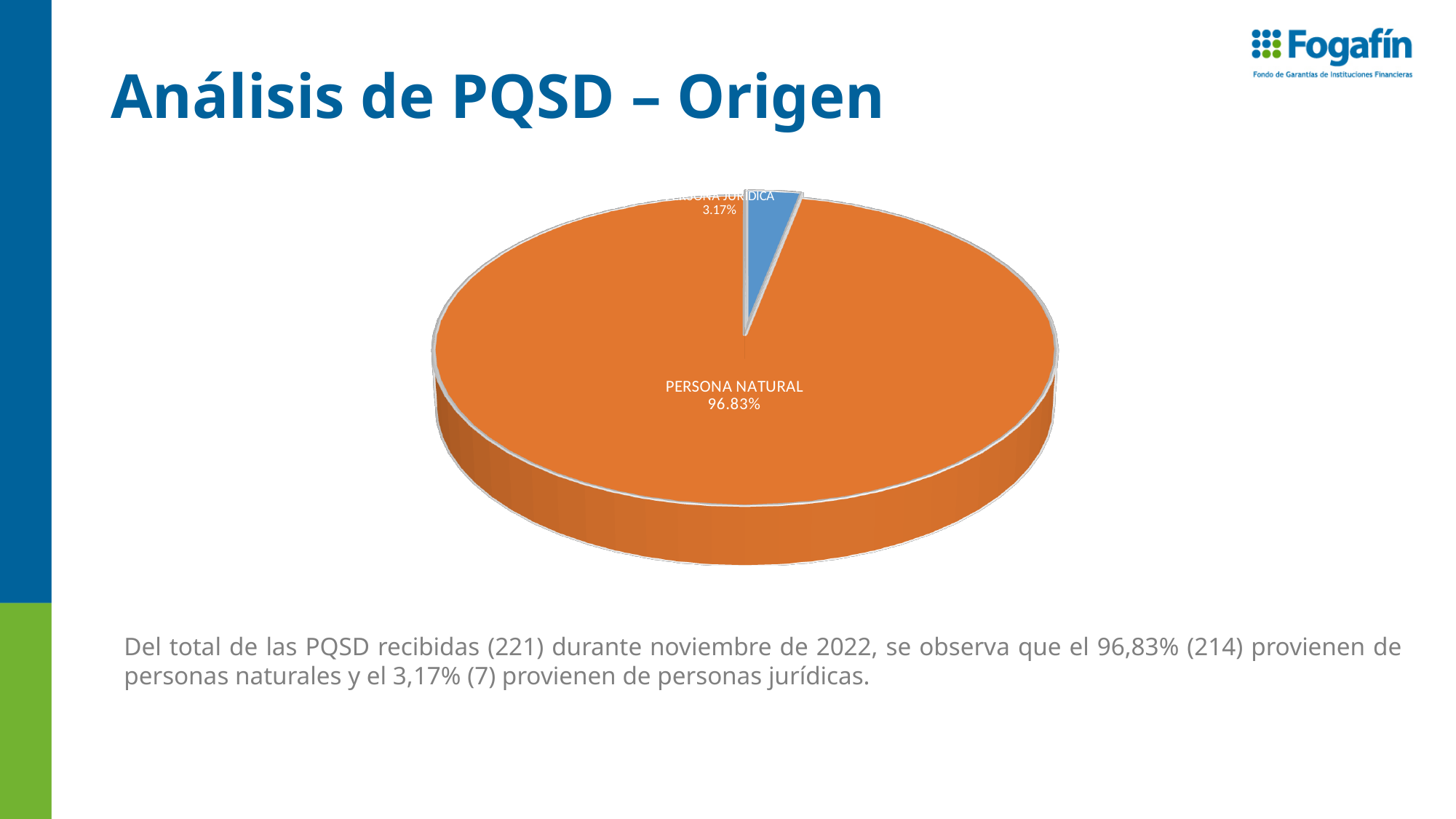
What kind of chart is shown on the slide? Pie chart What colour is the PERSONA NATURAL slice? Orange How many categories are shown in the pie chart? 2 What share of the pie does PERSONA NATURAL represent? 96.83% Which slice is larger, PERSONA NATURAL or PERSONA JURÍDICA? PERSONA NATURAL Which category has the smallest slice of the pie? PERSONA JURÍDICA What colour is the PERSONA JURÍDICA slice? Blue What share of the pie does PERSONA JURÍDICA represent? 3.17% What is the difference in percentage points between the PERSONA NATURAL and PERSONA JURÍDICA slices? 93.66 Which category has the largest slice of the pie? PERSONA NATURAL